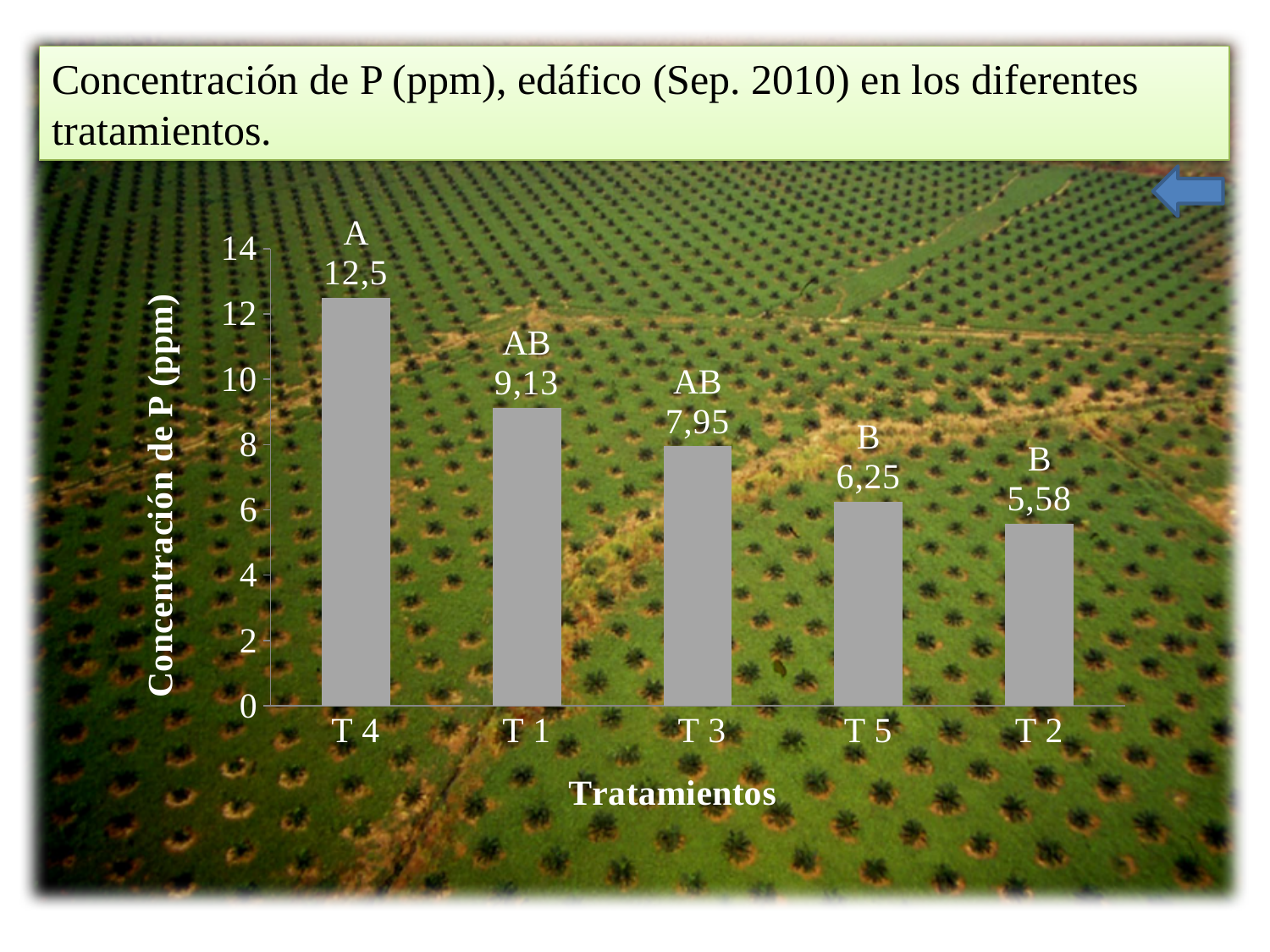
Is the value for T 1 greater or less than 10? less Which treatment has the highest P concentration? T 4 Which treatment has the lowest P concentration? T 2 Do the values rise or fall from left to right along the x axis? fall How many treatments are shown on the x axis? 5 What is the P concentration value shown for T 3? 7,95 Which has a larger value, T 3 or T 5? T 3 What is the P concentration value shown for T 4? 12,5 What is the difference between the values for T 1 and T 5? 2,88 What is the label of the y axis? Concentración de P (ppm) What is the P concentration value shown for T 2? 5,58 What kind of chart is shown on the slide? bar chart